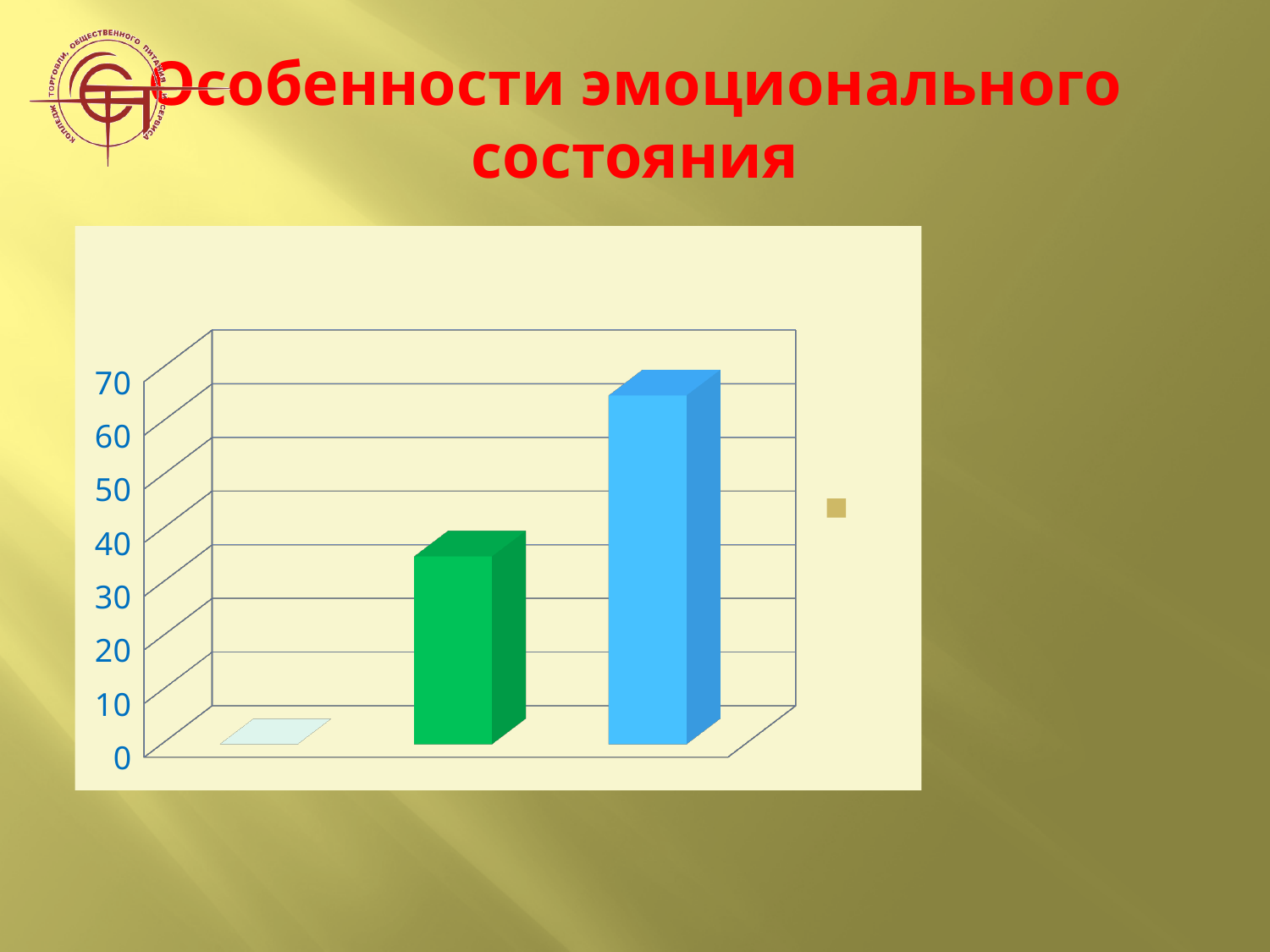
Is the value of the green bar greater or less than 40? less Which bar is the tallest in the chart: the first (light), the second (green) or the third (blue)? the third (blue) What is the highest value shown on the vertical axis of the chart? 70 Is the value of the blue bar greater or less than 60? greater Which is larger, the green bar or the blue bar? the blue bar How many bars are plotted in the chart? 3 Do the bar values rise or fall from left to right across the chart? rise Is the value of the first (light) bar greater or less than 10? less Which bar is the shortest in the chart: the first (light), the second (green) or the third (blue)? the first (light) What kind of chart is shown on the slide? bar chart What colour is the tallest bar in the chart? blue